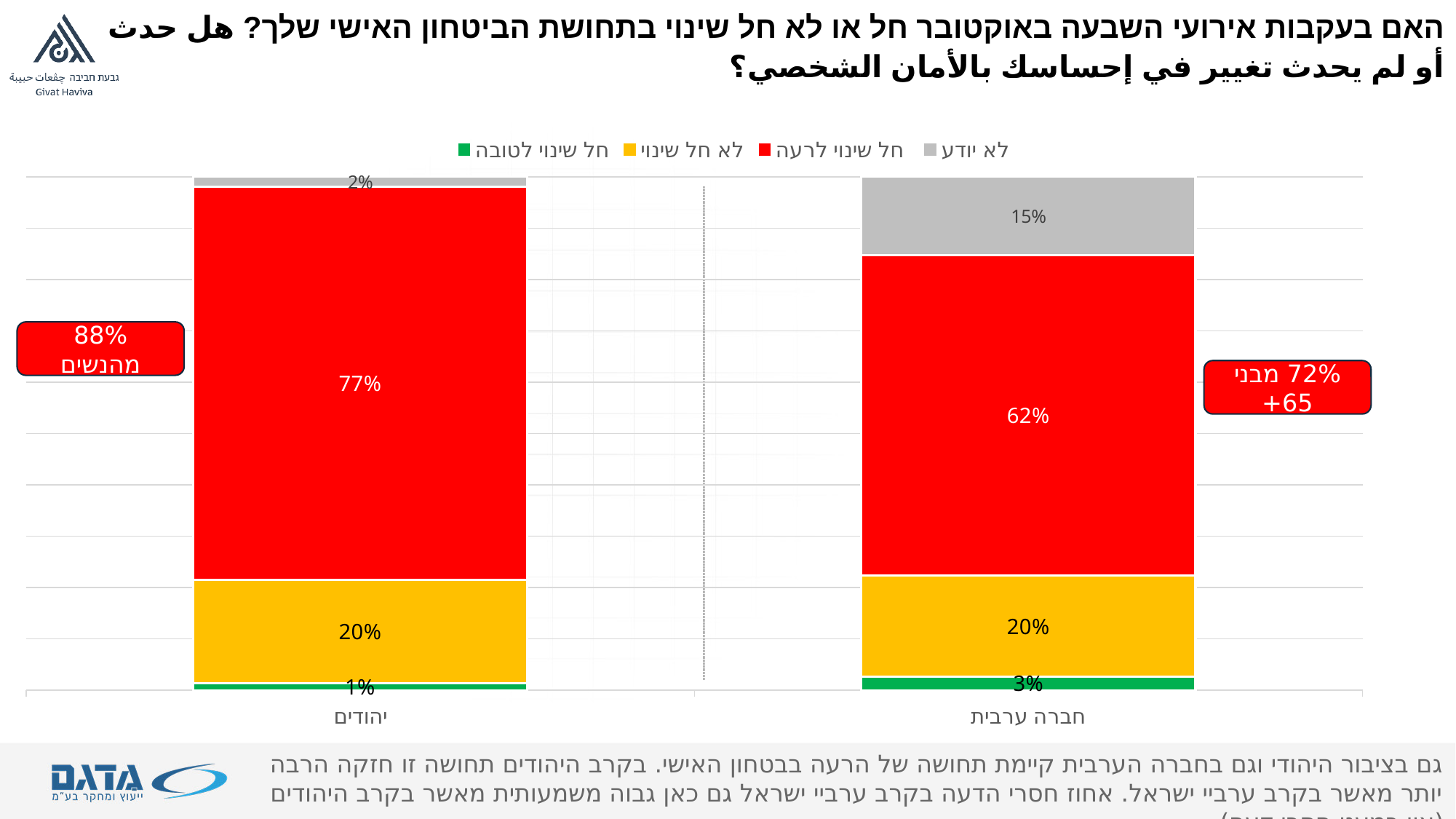
Which colour represents חל שינוי לרעה in the legend? red What is the value of חל שינוי לטובה for יהודים? 1% How many categories are shown on the x axis of the chart? 2 What is the value of חל שינוי לרעה for חברה ערבית? 62% What is the value of לא חל שינוי for חברה ערבית? 20% What kind of chart is shown on the slide? stacked bar chart What is the value of חל שינוי לרעה for יהודים? 77% How many series does the legend list? 4 What is the difference between the לא יודע values for חברה ערבית and יהודים? 13% What is the difference between the חל שינוי לרעה values for יהודים and חברה ערבית? 15% What is the value of לא יודע for חברה ערבית? 15% Which category has the higher value for חל שינוי לרעה, יהודים or חברה ערבית? יהודים